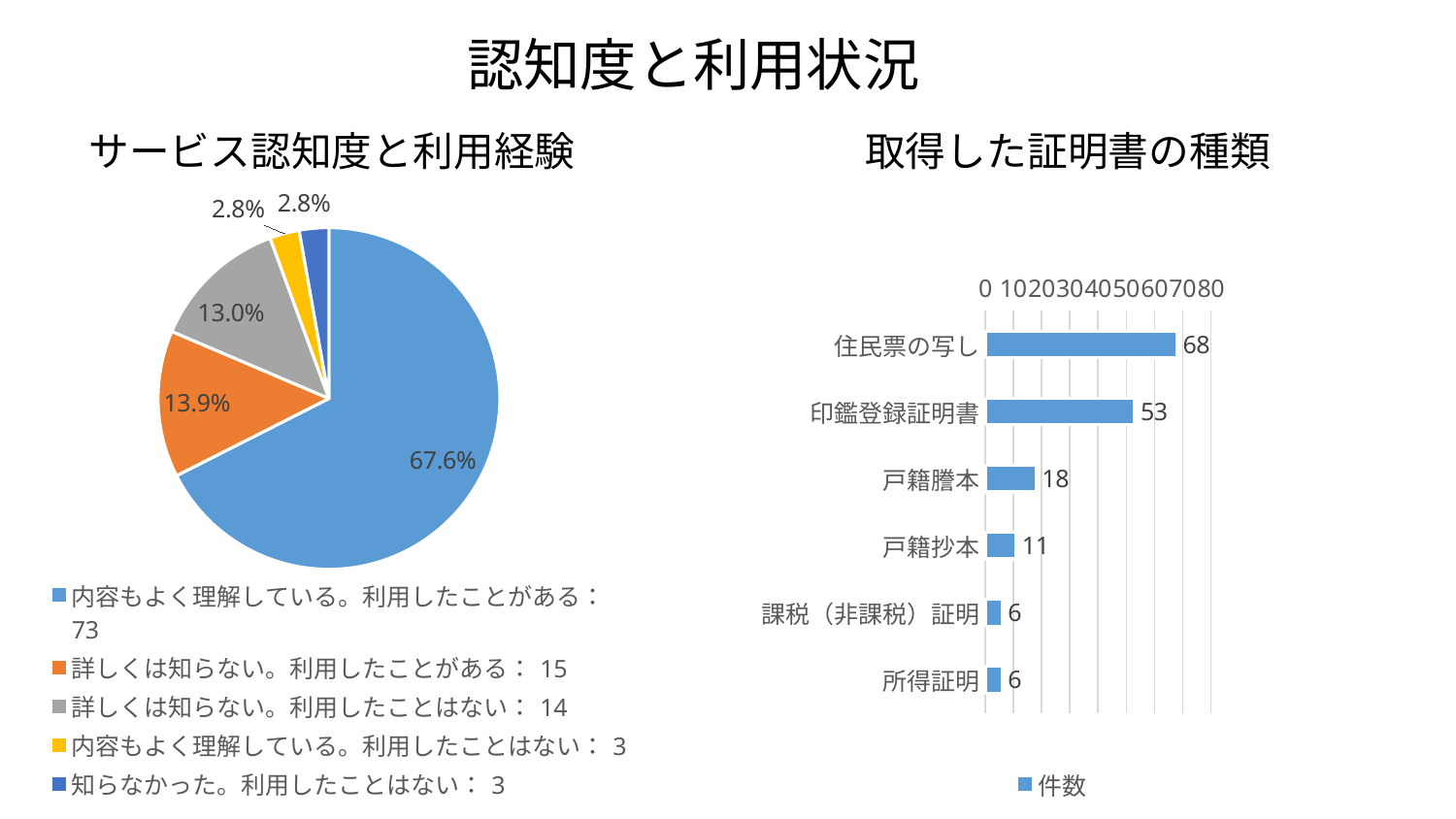
In the chart titled サービス認知度と利用経験, how many slices does the pie have? 5 What kind of chart is the chart titled サービス認知度と利用経験? pie chart In the chart titled 取得した証明書の種類, how many categories are shown? 6 What kind of chart is the chart titled 取得した証明書の種類? bar chart In the chart titled 取得した証明書の種類, which is larger, the value for 戸籍謄本 or the value for 戸籍抄本? 戸籍謄本 In the chart titled 取得した証明書の種類, what series name does the legend show? 件数 In the chart titled 取得した証明書の種類, what is the difference between the values for 住民票の写し and 印鑑登録証明書? 15 In the chart titled サービス認知度と利用経験, what share of the pie is 詳しくは知らない。利用したことはない? 13.0% In the chart titled サービス認知度と利用経験, what share of the pie is 内容もよく理解している。利用したことがある? 67.6% In the chart titled 取得した証明書の種類, what is the value for 印鑑登録証明書? 53 In the chart titled 取得した証明書の種類, which category has the highest value? 住民票の写し In the chart titled 取得した証明書の種類, what is the value for 住民票の写し? 68